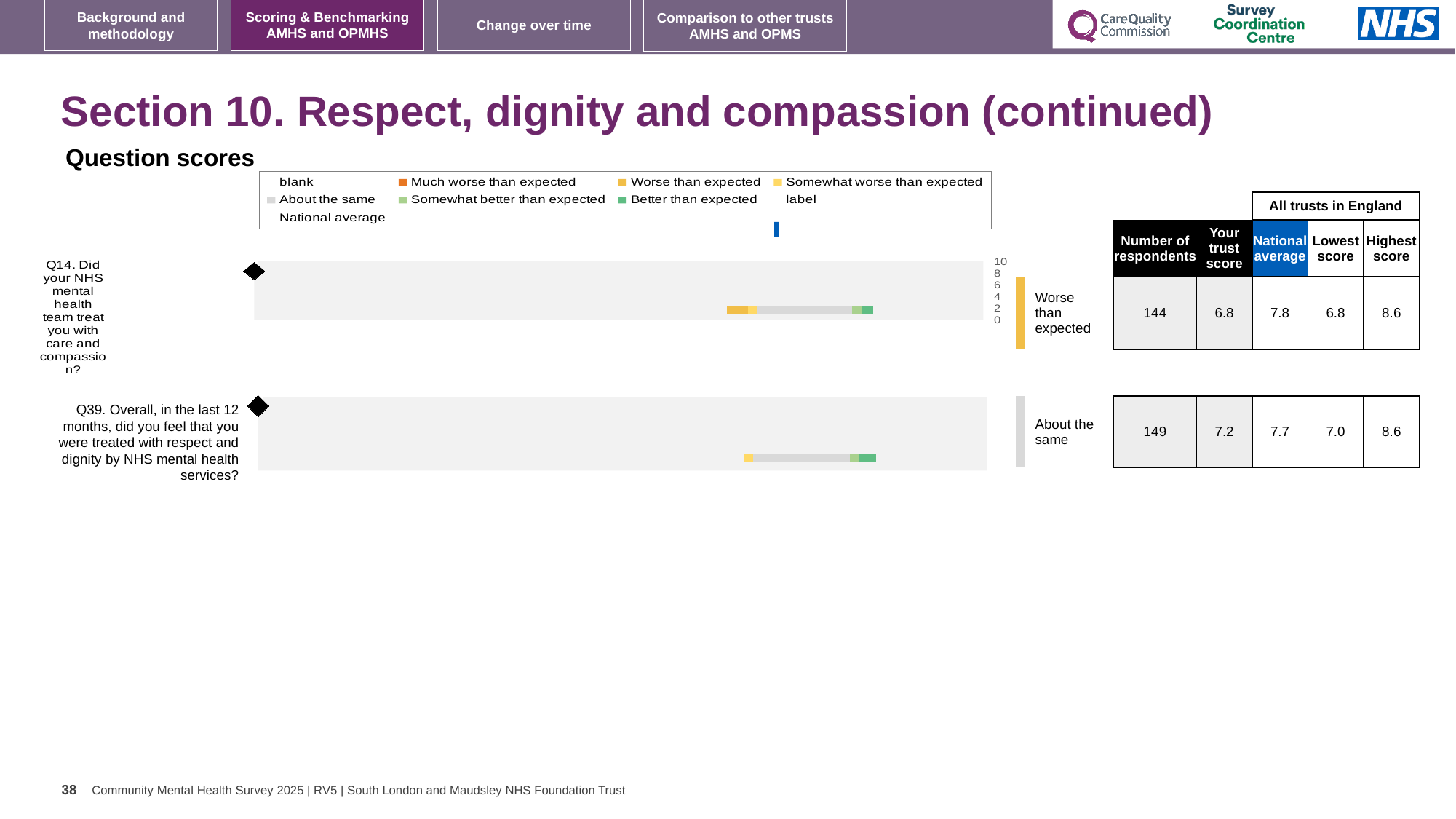
What is the lowest score among all trusts in England for Q14? 6.8 What is the highest score among all trusts in England for Q39? 8.6 How many questions are plotted in the chart? 2 What type of chart is used to show the question scores? Bar chart How many respondents are shown for Q14 (care and compassion)? 144 What is the national average for Q14? 7.8 For Q14, which is larger: the trust score or the national average? National average Which question has the higher number of respondents, Q14 or Q39? Q39 What is the trust score for Q39 (treated with respect and dignity)? 7.2 Which benchmark category is Q39 placed in? About the same For Q39, what is the difference between the national average and the trust score? 0.5 Which benchmark category is Q14 placed in? Worse than expected